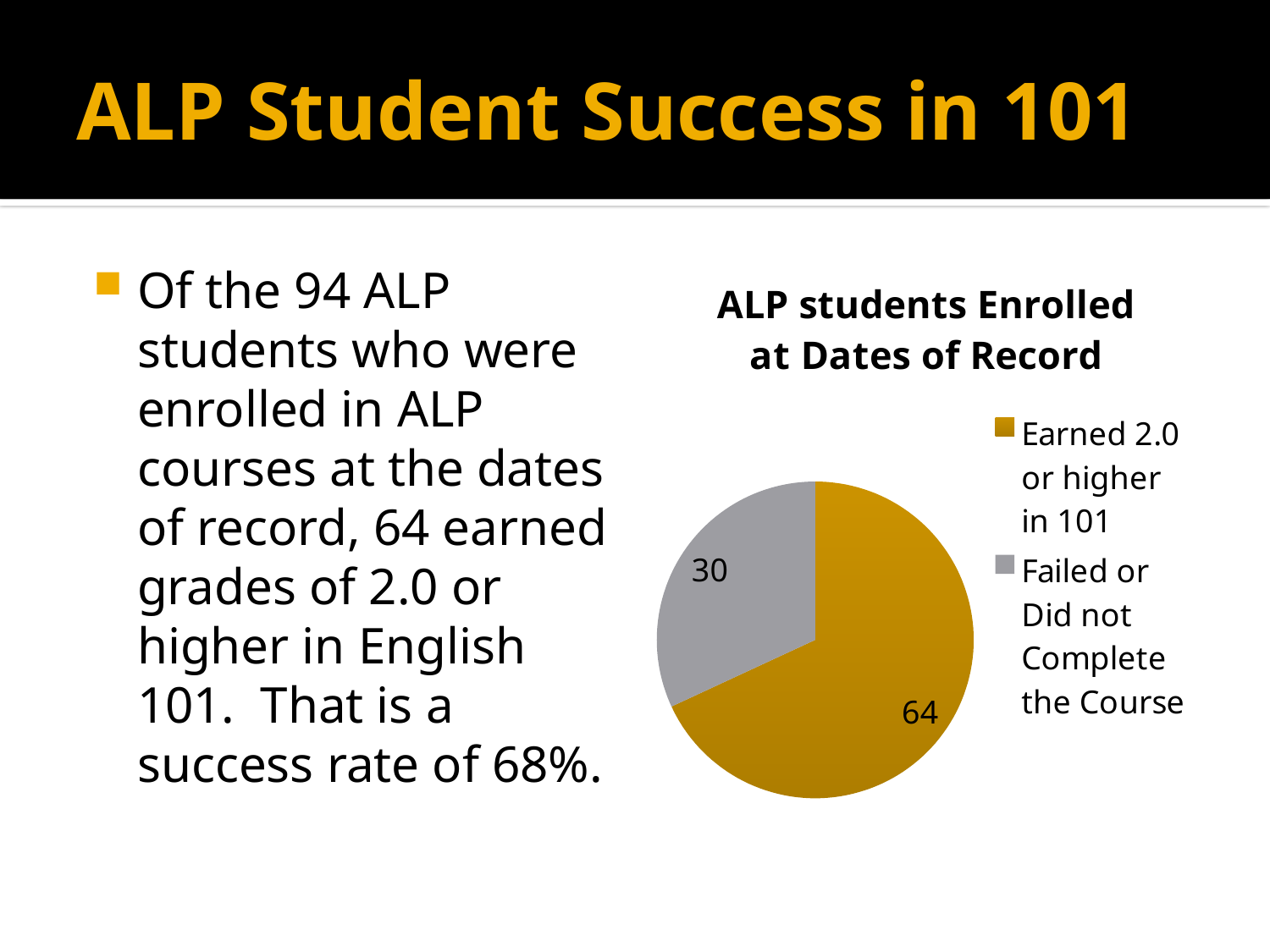
What is the title of the chart? ALP students Enrolled at Dates of Record Which category has the largest slice of the pie? Earned 2.0 or higher in 101 Which is larger: the number who earned 2.0 or higher in 101 or the number who failed or did not complete the course? Earned 2.0 or higher in 101 What is the difference between the number who earned 2.0 or higher and the number who failed or did not complete? 34 How many categories does the pie chart show? 2 What is the total of the two slices in the pie chart? 94 What colour is the slice for 'Failed or Did not Complete the Course'? Gray What type of chart is shown on the slide? Pie chart What share of the pie does the 'Earned 2.0 or higher in 101' slice represent? 68% Which category has the smallest slice of the pie? Failed or Did not Complete the Course How many students earned 2.0 or higher in 101 according to the chart? 64 How many students failed or did not complete the course according to the chart? 30